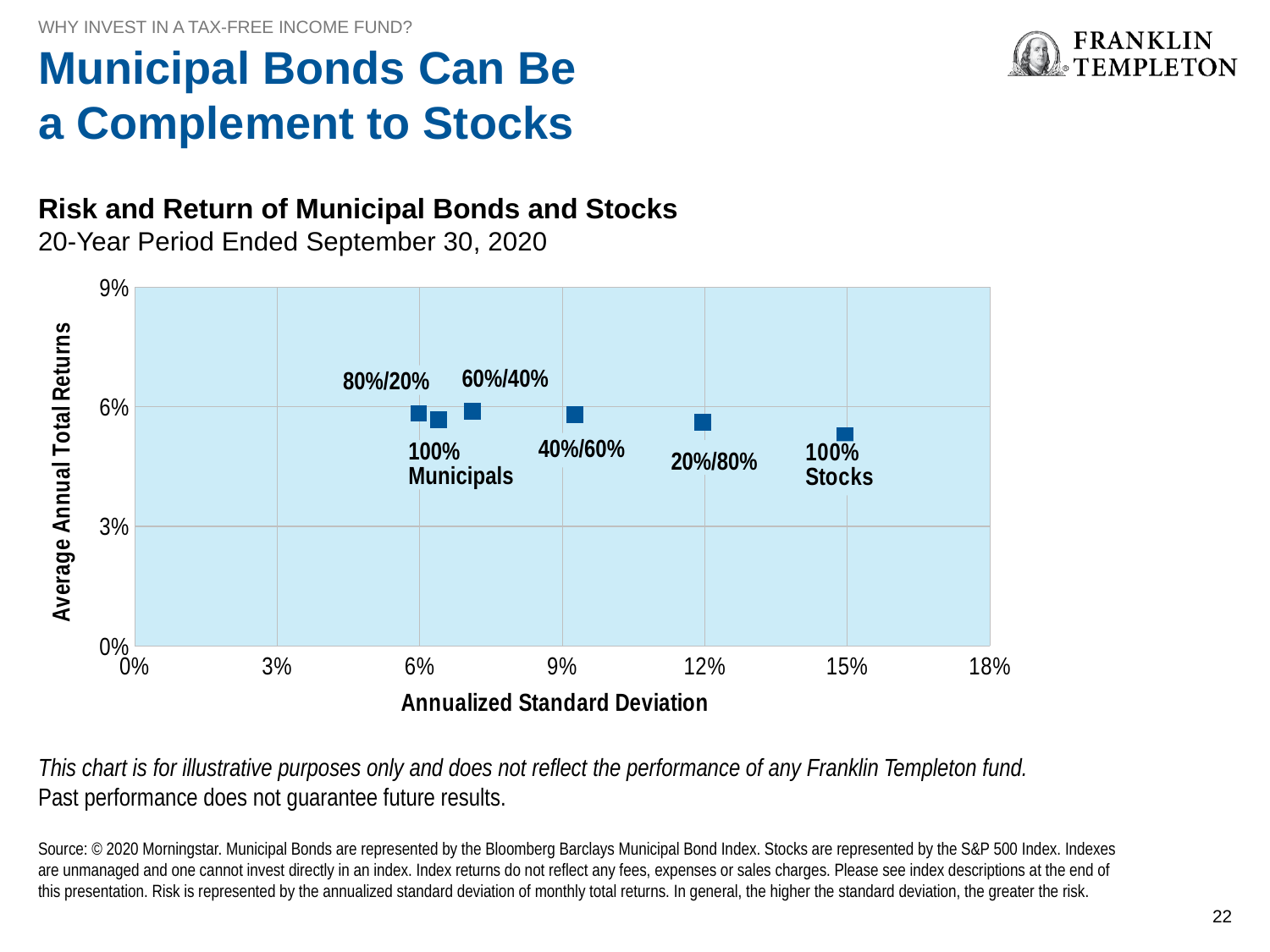
What time period does the chart cover? 20-Year Period Ended September 30, 2020 What kind of chart is shown on the slide? Scatter chart Which portfolio has the lowest average annual total return? 100% Stocks Is the average annual total return for 100% Stocks greater or less than 6%? less Which has the larger annualized standard deviation, 20%/80% or 40%/60%? 20%/80% Is the annualized standard deviation for 60%/40% greater or less than 9%? less Is the annualized standard deviation for 100% Stocks greater or less than 12%? greater How many data points are plotted on the chart? 6 What is the title of the chart's x axis? Annualized Standard Deviation Which has the larger annualized standard deviation, 100% Stocks or 100% Municipals? 100% Stocks Which portfolio has the highest annualized standard deviation? 100% Stocks